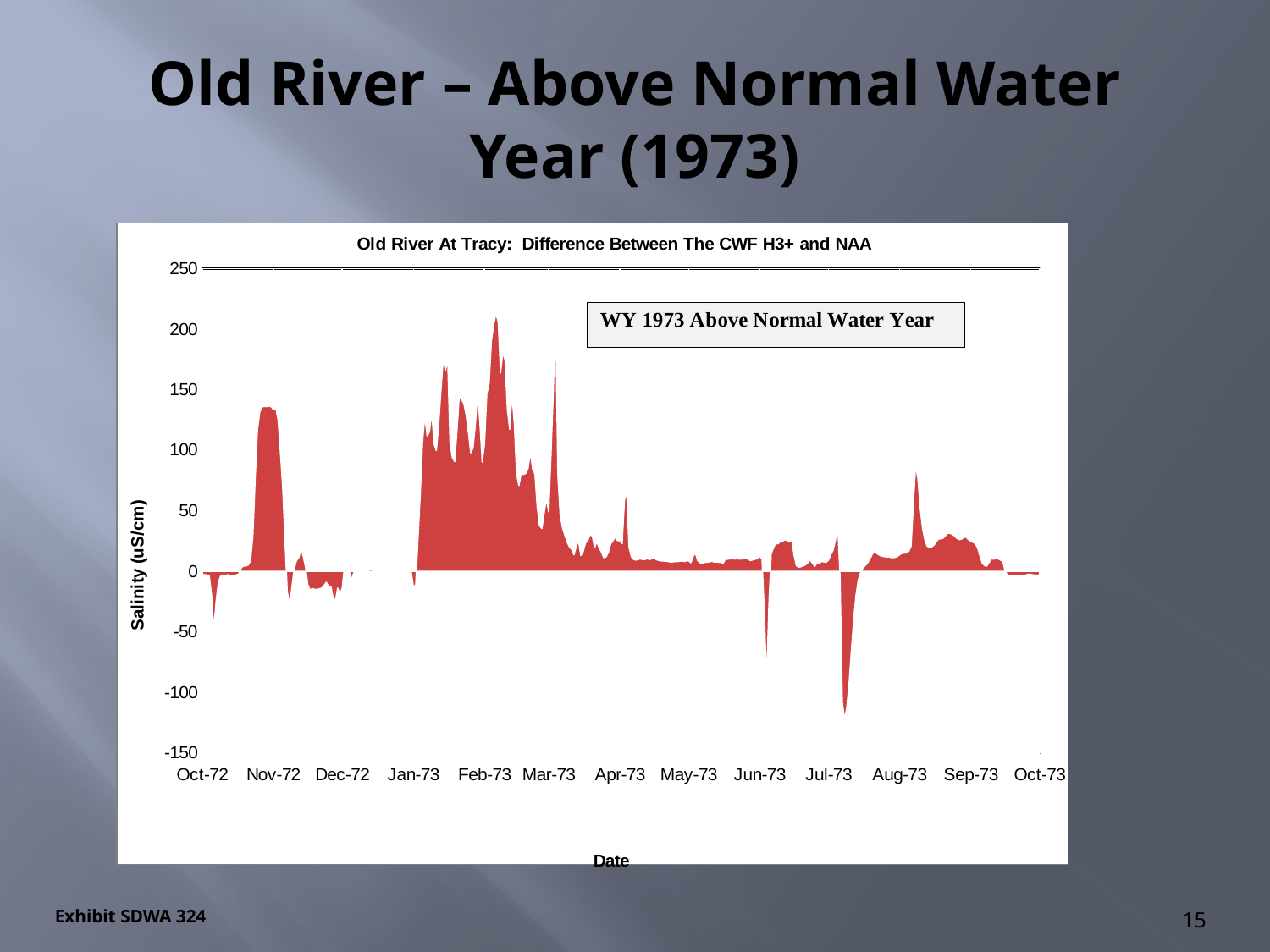
How many month labels are shown along the horizontal axis of the chart? 13 Is the peak value near Feb-73 greater or less than 150? greater What is the label of the vertical axis of the chart? Salinity (uS/cm) What is the title of the chart? Old River At Tracy: Difference Between The CWF H3+ and NAA What is the lowest value shown on the vertical axis of the chart? -150 Is the peak value near Nov-72 greater or less than 150? less Which is larger, the peak near Nov-72 or the peak near Feb-73? Feb-73 Is the lowest value near Jun-73 greater or less than -50? less What kind of chart is shown on the slide? Area chart Around which month does the chart reach its lowest (most negative) value? Jul-73 Around which month does the chart reach its highest peak? Feb-73 What is the highest value shown on the vertical axis of the chart? 250